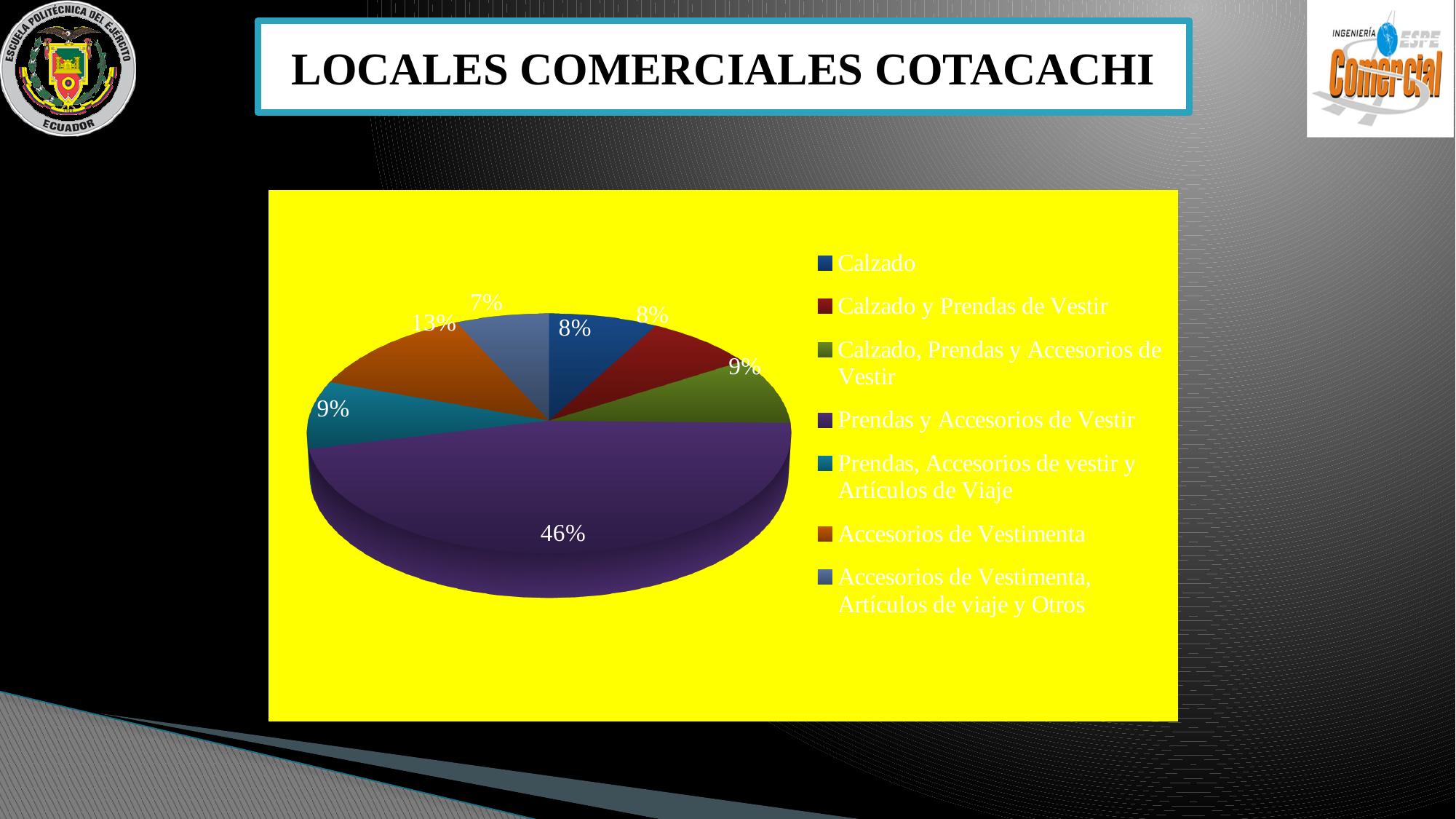
How many slices does the pie chart have? 7 Which category has the smallest share of the pie? Accesorios de Vestimenta, Artículos de viaje y Otros What percentage is shown for Calzado? 8% What is the difference in percentage points between Prendas y Accesorios de Vestir and Accesorios de Vestimenta? 33 percentage points Which category has the largest share of the pie? Prendas y Accesorios de Vestir What is the title shown above the chart? LOCALES COMERCIALES COTACACHI Which is larger, the share for Accesorios de Vestimenta or the share for Calzado y Prendas de Vestir? Accesorios de Vestimenta What share of the pie does Prendas y Accesorios de Vestir represent? 46% How many entries does the legend list? 7 What kind of chart is shown on the slide? Pie chart What percentage is shown for Accesorios de Vestimenta? 13% What percentage is shown for Prendas, Accesorios de vestir y Artículos de Viaje? 9%